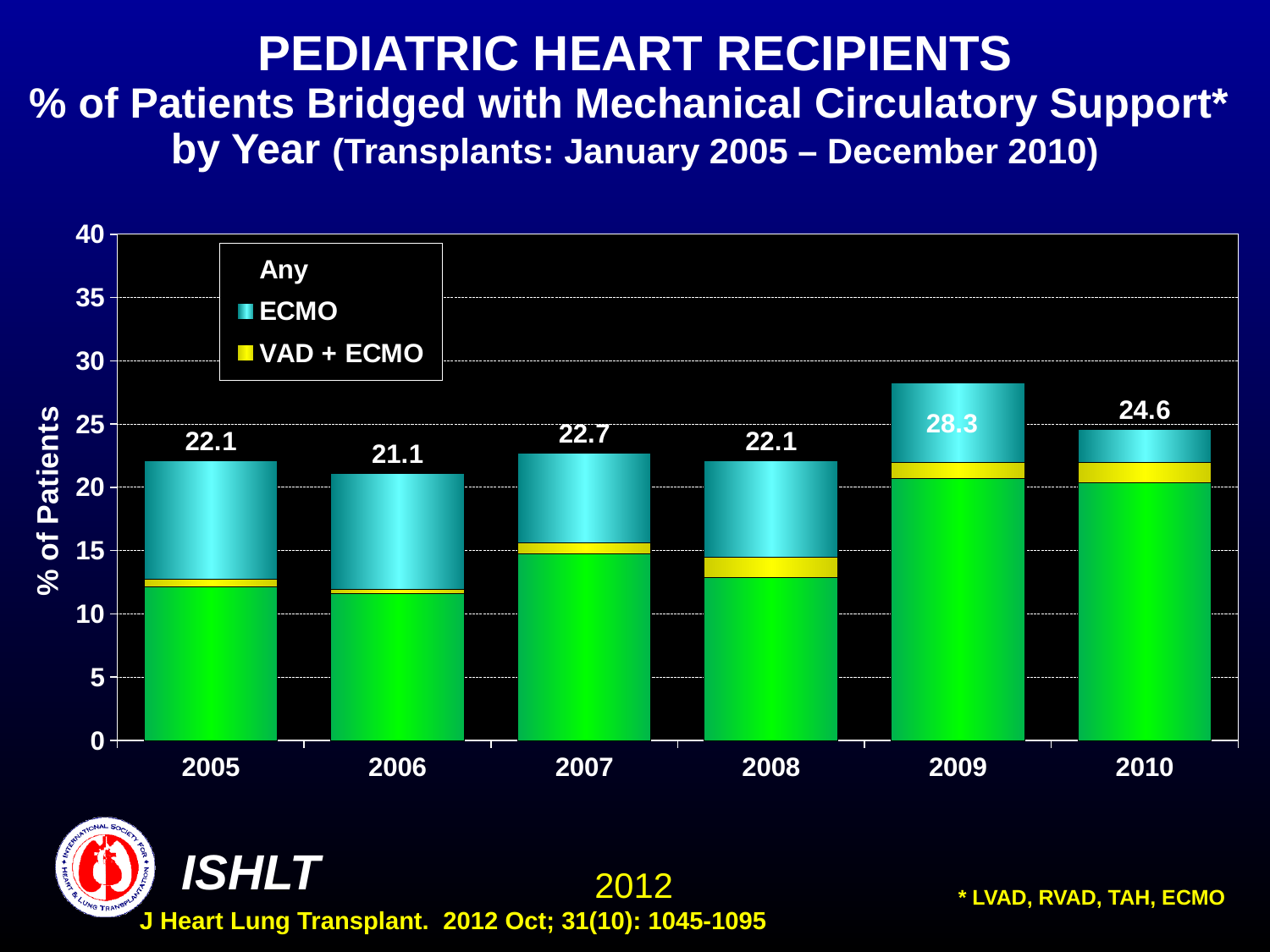
How many entries does the legend list? 3 What is the total percentage of patients bridged with mechanical circulatory support in 2009? 28.3 Which year has a larger total value, 2007 or 2008? 2007 What is the total value shown above the bar for 2006? 21.1 Which year has the lowest total percentage of patients bridged with mechanical circulatory support? 2006 What is the difference between the total values for 2009 and 2010? 3.7 What kind of chart is shown on the slide? Stacked bar chart Which year has the highest total percentage of patients bridged with mechanical circulatory support? 2009 What is the total value shown above the bar for 2010? 24.6 What is the label on the y axis? % of Patients Is the green (bottom) segment of the 2009 bar greater or less than 15? greater How many years are shown on the x axis? 6